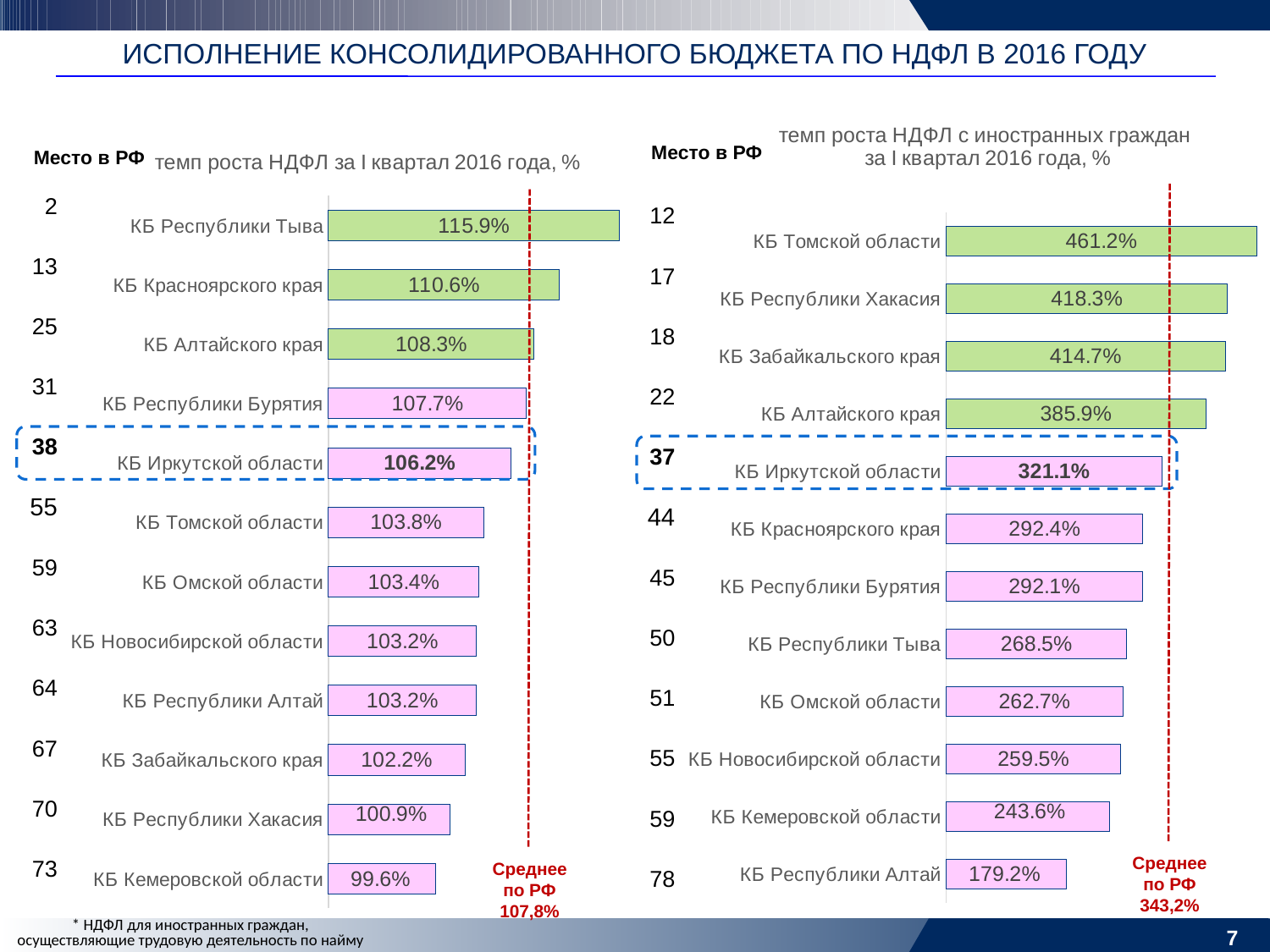
How many categories are shown in the left chart? 12 How many categories are shown in the right chart? 12 In the right chart, what is the difference between the values for КБ Республики Хакасия and КБ Забайкальского края? 3.6% In the right chart, which category has the lowest value? КБ Республики Алтай In the left chart, what is the value for КБ Кемеровской области? 99.6% What is the average for the Russian Federation (Среднее по РФ) shown on the right chart? 343,2% In the left chart (темп роста НДФЛ за I квартал 2016 года), what is the value for КБ Иркутской области? 106.2% In the left chart, what is the difference between the values for КБ Республики Тыва and КБ Кемеровской области? 16.3% In the right chart, which is larger: the value for КБ Красноярского края or КБ Республики Тыва? КБ Красноярского края In the left chart, which category has the highest value? КБ Республики Тыва What type of chart is the right chart? Bar chart In the right chart (темп роста НДФЛ с иностранных граждан), what is the value for КБ Томской области? 461.2%